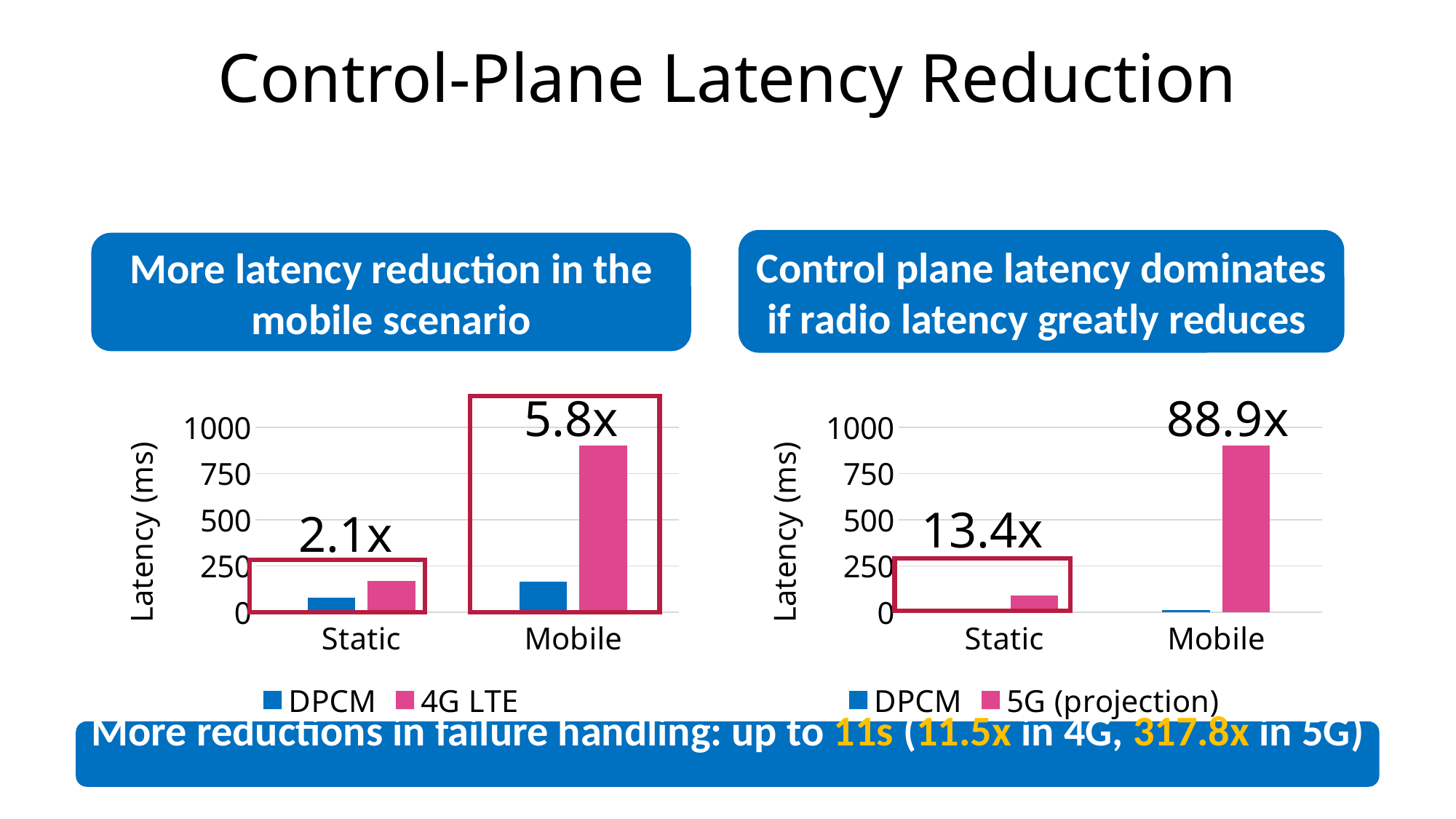
In the right chart (DPCM vs 5G projection), is the 5G (projection) value for Mobile greater or less than 750? greater In the right chart (DPCM vs 5G projection), which is larger for Static: DPCM or 5G (projection)? 5G (projection) In the left chart (DPCM vs 4G LTE), does the 4G LTE value rise or fall from Static to Mobile? rise How many categories are shown on the x axis of the left chart (DPCM vs 4G LTE)? 2 In the left chart (DPCM vs 4G LTE), which is larger for Mobile: DPCM or 4G LTE? 4G LTE What kind of chart is the left chart (DPCM vs 4G LTE)? bar chart What is the y-axis label of the right chart (DPCM vs 5G projection)? Latency (ms) In the left chart (DPCM vs 4G LTE), is the DPCM value for Mobile greater or less than 250? less In the left chart (DPCM vs 4G LTE), is the 4G LTE value for Static greater or less than 250? less In the left chart (DPCM vs 4G LTE), which bar is the tallest? 4G LTE, Mobile What reduction factor is annotated above the Mobile group in the right chart (DPCM vs 5G projection)? 88.9x How many series does the legend of the right chart (DPCM vs 5G projection) list? 2